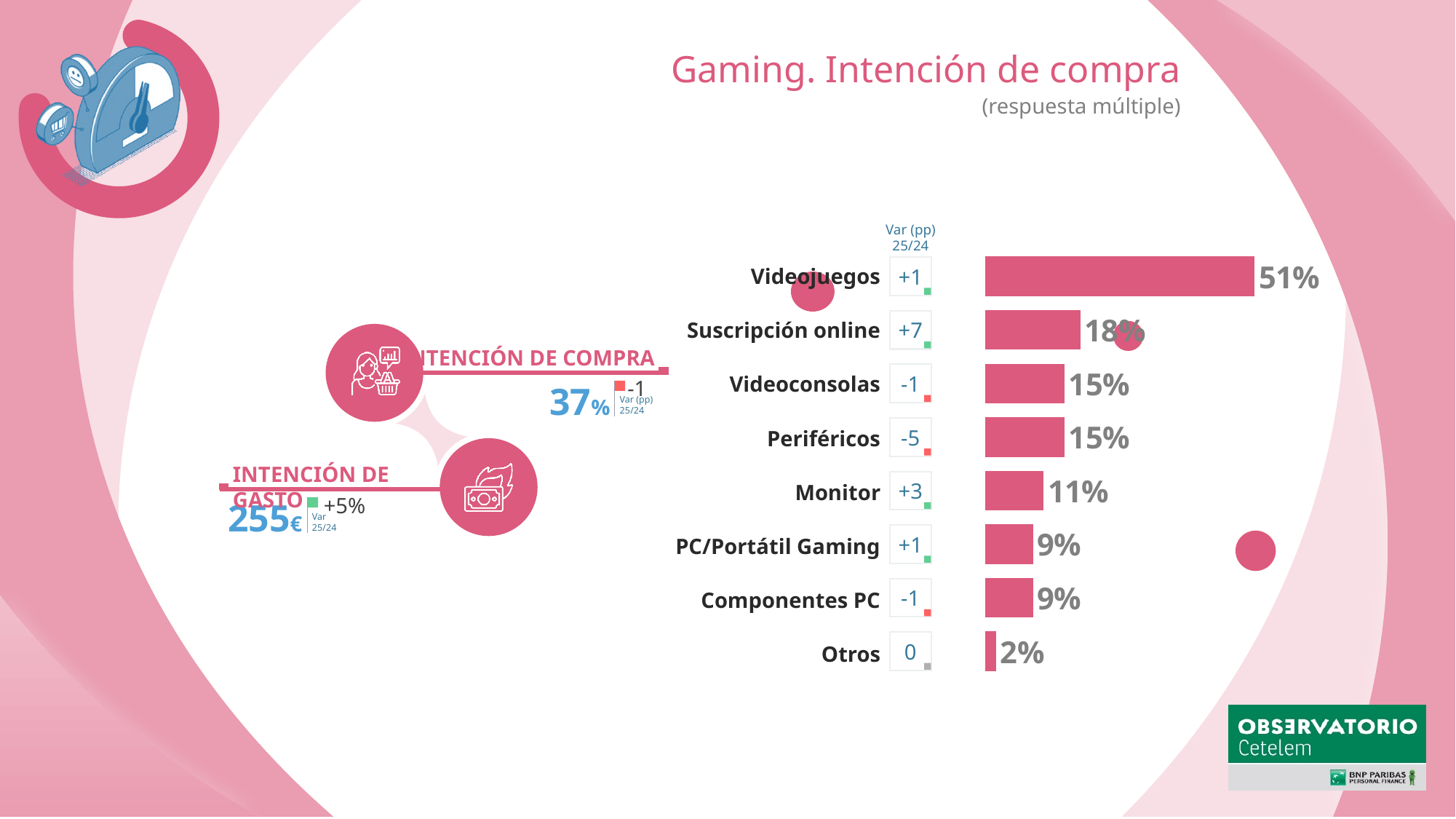
What is the difference between the values for Videojuegos and Suscripción online? 33 percentage points What kind of chart is shown on the slide? Bar chart How many categories are shown in the bar chart? 8 What is the value for Suscripción online? 18% What is the value for Videojuegos? 51% Which is larger, the value for Videoconsolas or the value for Monitor? Videoconsolas What is the value for Monitor? 11% What is the value for Otros? 2% What is the Var (pp) 25/24 value shown for Periféricos? -5 Which category has the lowest value? Otros What is the Var (pp) 25/24 value shown for Suscripción online? +7 Which category has the highest value? Videojuegos